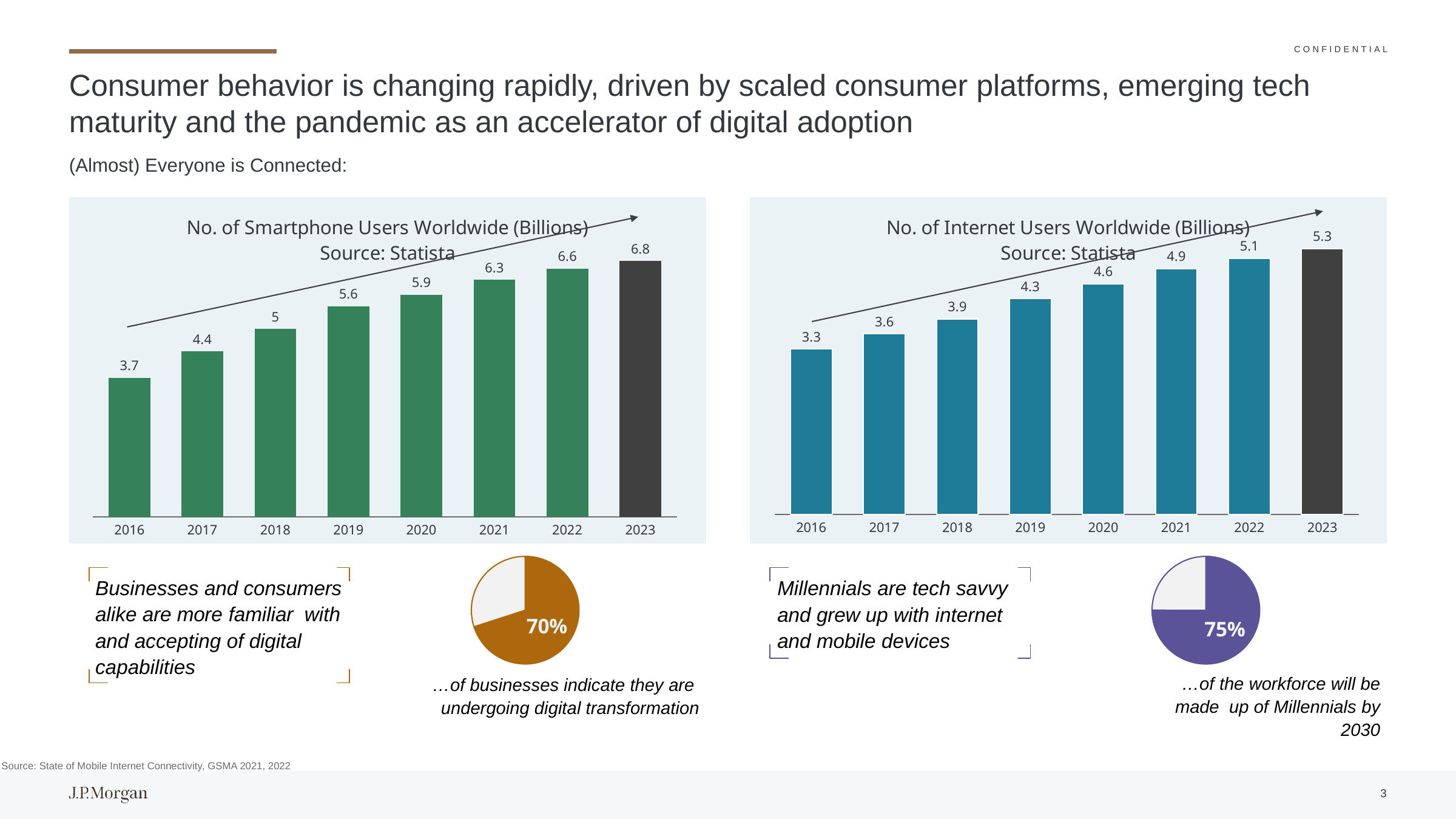
In the 'No. of Smartphone Users Worldwide (Billions)' chart, what is the difference between the 2023 and 2016 values? 3.1 What percentage is shown in the orange pie chart below the smartphone users chart? 70% In the 'No. of Internet Users Worldwide (Billions)' chart, what is the value for 2020? 4.6 In the 'No. of Smartphone Users Worldwide (Billions)' chart, what is the value for 2019? 5.6 What kind of chart is the 'No. of Smartphone Users Worldwide (Billions)' chart? Bar chart What percentage is shown in the purple pie chart below the internet users chart? 75% In the 'No. of Smartphone Users Worldwide (Billions)' chart, which is larger, the value for 2018 or the value for 2021? 2021 In the 'No. of Internet Users Worldwide (Billions)' chart, which year has the lowest value? 2016 In the 'No. of Internet Users Worldwide (Billions)' chart, what is the difference between the 2022 and 2021 values? 0.2 In the 'No. of Smartphone Users Worldwide (Billions)' chart, which year has the highest value? 2023 In the 'No. of Internet Users Worldwide (Billions)' chart, do the values rise or fall from 2016 to 2023? Rise How many years are shown in the 'No. of Internet Users Worldwide (Billions)' chart? 8